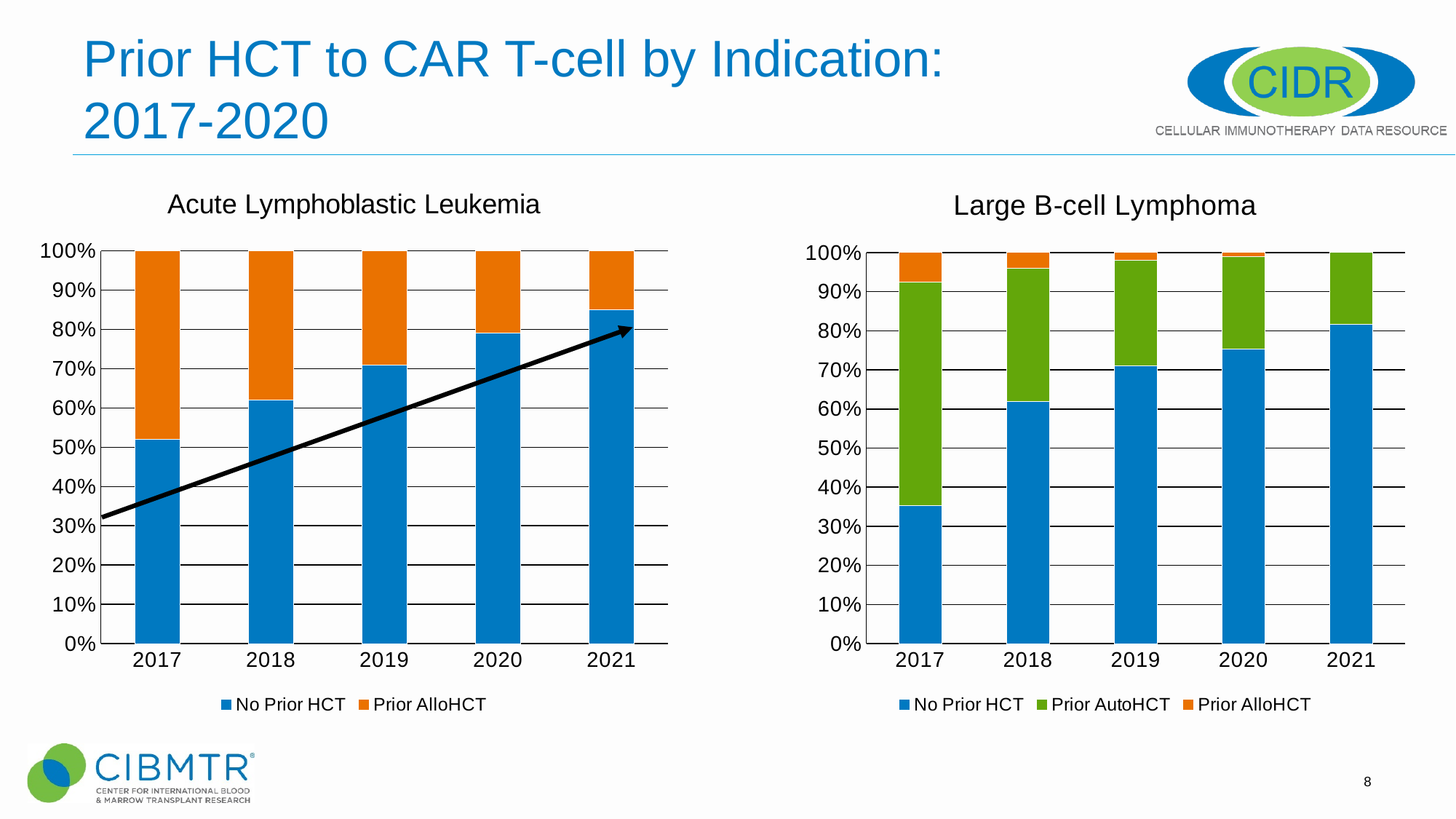
In the Acute Lymphoblastic Leukemia chart, is the No Prior HCT value for 2021 greater or less than 80%? greater In the Large B-cell Lymphoma chart, does the Prior AutoHCT share rise or fall from 2017 to 2021? Fall In the Acute Lymphoblastic Leukemia chart, does the No Prior HCT share rise or fall from 2017 to 2021? Rise How many series does the legend of the Large B-cell Lymphoma chart list? 3 How many series does the legend of the Acute Lymphoblastic Leukemia chart list? 2 In the Large B-cell Lymphoma chart, which year has the highest No Prior HCT share? 2021 In the Acute Lymphoblastic Leukemia chart, which year has the lowest No Prior HCT share? 2017 In the Acute Lymphoblastic Leukemia chart, is the No Prior HCT value for 2017 greater or less than 60%? less In the Large B-cell Lymphoma chart, is the No Prior HCT value for 2017 greater or less than 40%? less In the Large B-cell Lymphoma chart, which series is shown in green? Prior AutoHCT What kind of chart is the Acute Lymphoblastic Leukemia chart? Stacked bar chart How many years are shown on the x axis of the Large B-cell Lymphoma chart? 5